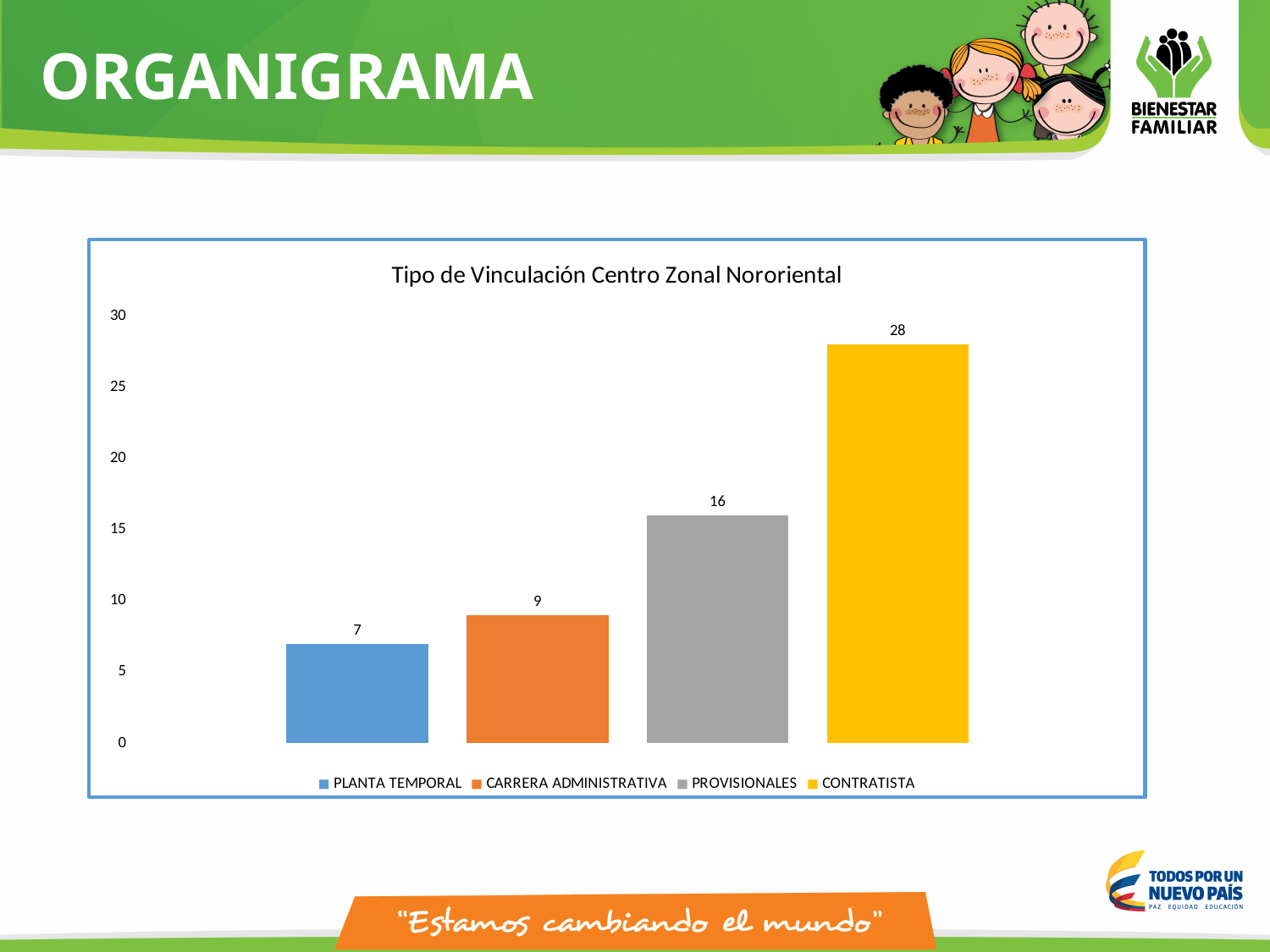
What is the value for PROVISIONALES? 16 What is the value for CONTRATISTA? 28 Do the values rise or fall from left to right across the bars? Rise What kind of chart is shown on the slide? Bar chart What is the difference between the values for CONTRATISTA and PROVISIONALES? 12 What is the value for PLANTA TEMPORAL? 7 Which is larger, the value for CARRERA ADMINISTRATIVA or the value for PLANTA TEMPORAL? CARRERA ADMINISTRATIVA Which category has the highest value? CONTRATISTA What is the value for CARRERA ADMINISTRATIVA? 9 What is the title of the chart? Tipo de Vinculación Centro Zonal Nororiental Which category has the lowest value? PLANTA TEMPORAL How many categories are shown in the chart? 4